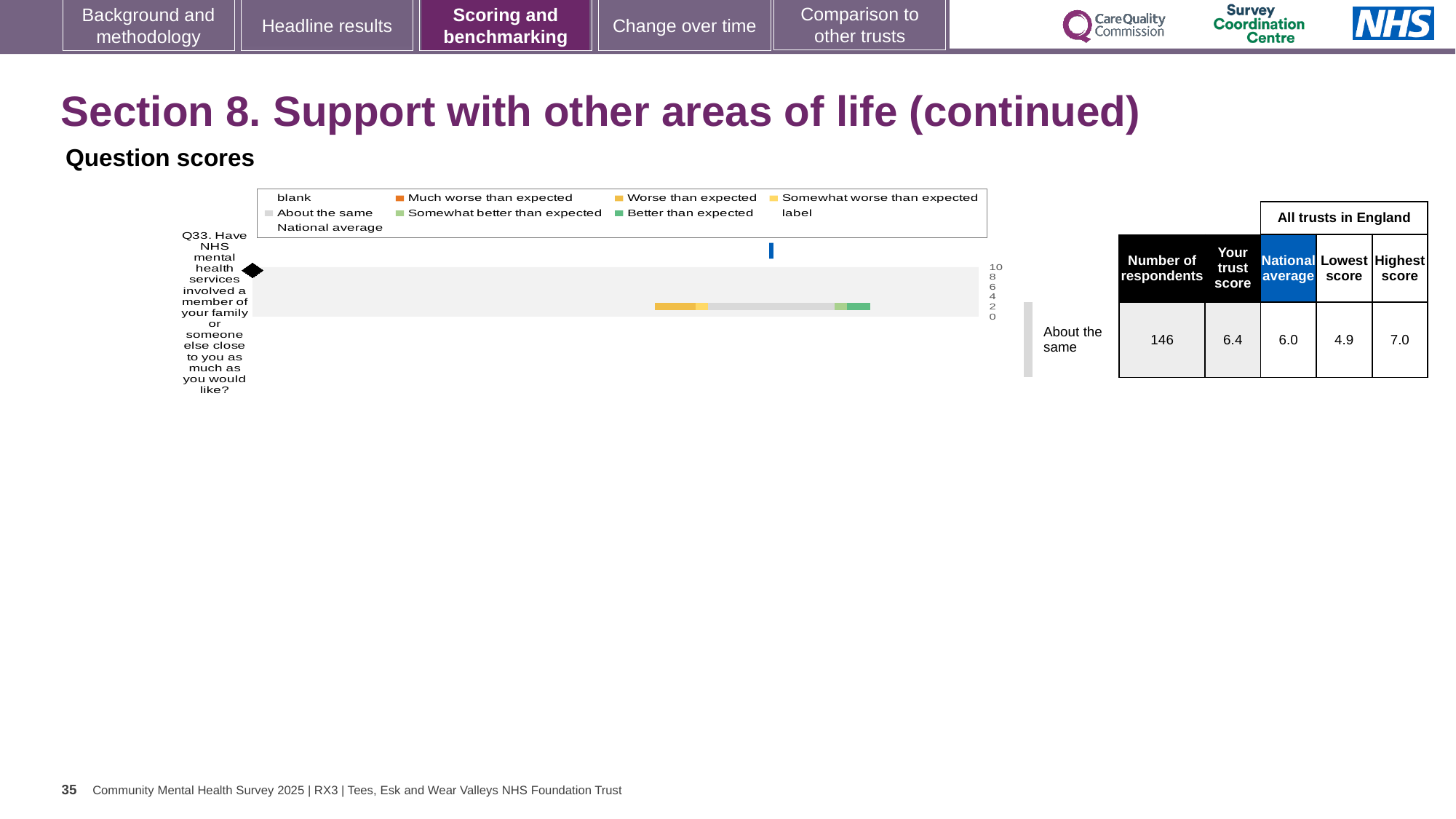
How many questions (categories) are plotted in the chart? 1 How many entries does the chart legend list? 9 What is the lowest score among all trusts in England for Q33? 4.9 Is the trust score for Q33 higher or lower than the national average? higher What is the trust score for Q33 shown in the table beside the chart? 6.4 Which question is plotted in the chart? Q33. Have NHS mental health services involved a member of your family or someone else close to you as much as you would like? What is the number of respondents for Q33? 146 What is the national average for Q33 shown in the table beside the chart? 6.0 What rating label is shown next to the bar for Q33? About the same What is the difference between the highest and lowest scores among all trusts in England for Q33? 2.1 What is the highest score among all trusts in England for Q33? 7.0 What kind of chart is shown under 'Question scores'? bar chart